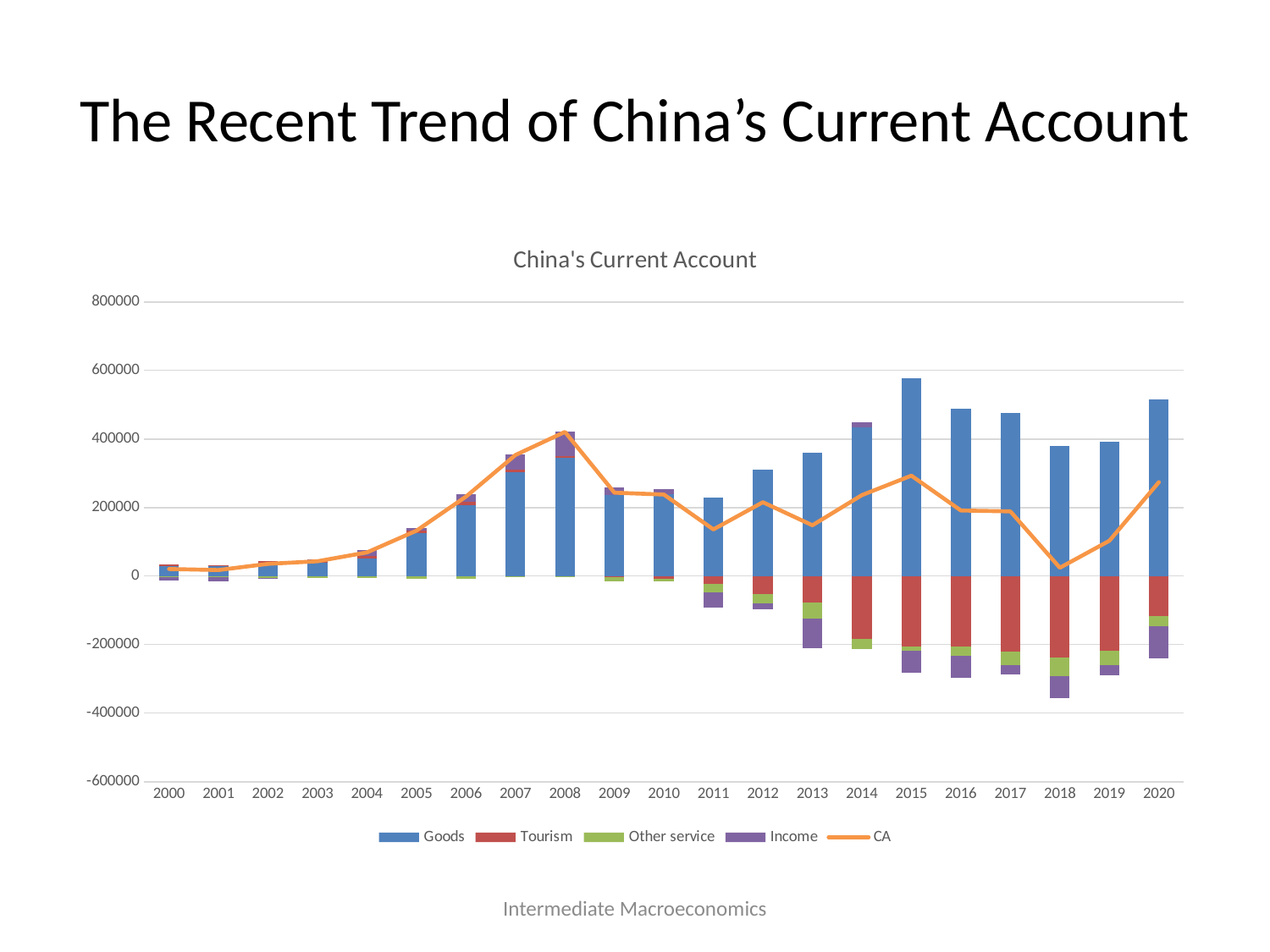
How many years are shown on the x axis? 21 In which year is the Goods bar highest? 2015 Which series is drawn as a line rather than bars? CA Which is larger, the Goods value in 2015 or in 2016? 2015 Between 2010 and 2020, in which year is the CA line lowest? 2018 Is the CA value for 2018 greater or less than 200000? less Does the CA line rise or fall from 2003 to 2008? rise In which year does the CA line reach its peak? 2008 What is the title of the chart? China's Current Account What kind of chart is this? Stacked bar chart with a line Is the Goods value for 2015 greater or less than 400000? greater How many series does the legend list? 5